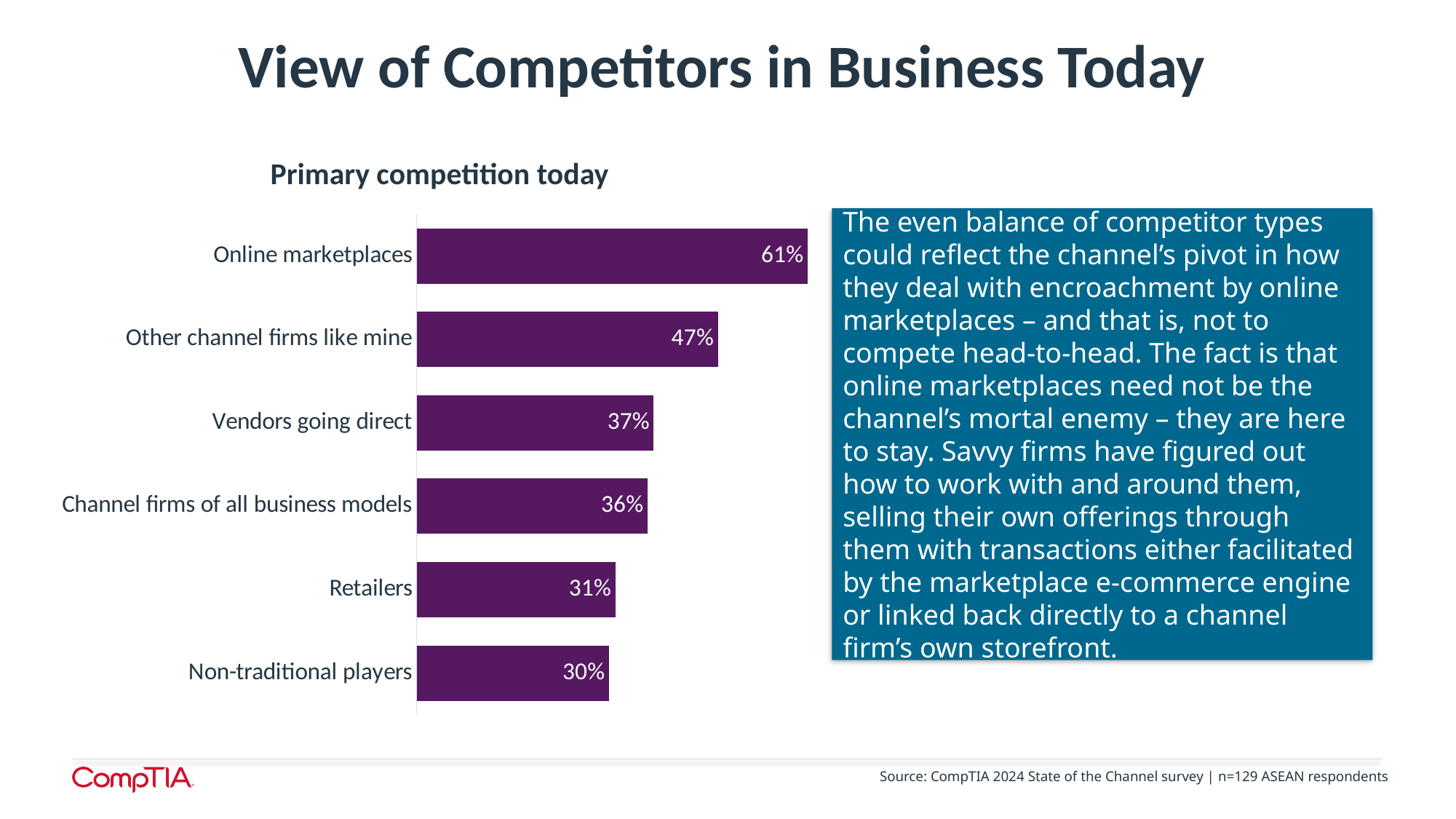
What is the value shown for 'Vendors going direct'? 37% Which has a larger value: 'Other channel firms like mine' or 'Channel firms of all business models'? Other channel firms like mine What type of chart is shown on the slide? Bar chart What is the difference between the values for 'Retailers' and 'Non-traditional players'? 1% What is the value shown for 'Non-traditional players'? 30% What is the title of the chart? Primary competition today What is the difference between the values for 'Online marketplaces' and 'Other channel firms like mine'? 14% How many categories are shown in the chart? 6 Which category has the highest value in the chart? Online marketplaces What colour are the bars in the chart? Purple Which category has the lowest value in the chart? Non-traditional players What percentage of respondents cite online marketplaces as their primary competition today? 61%